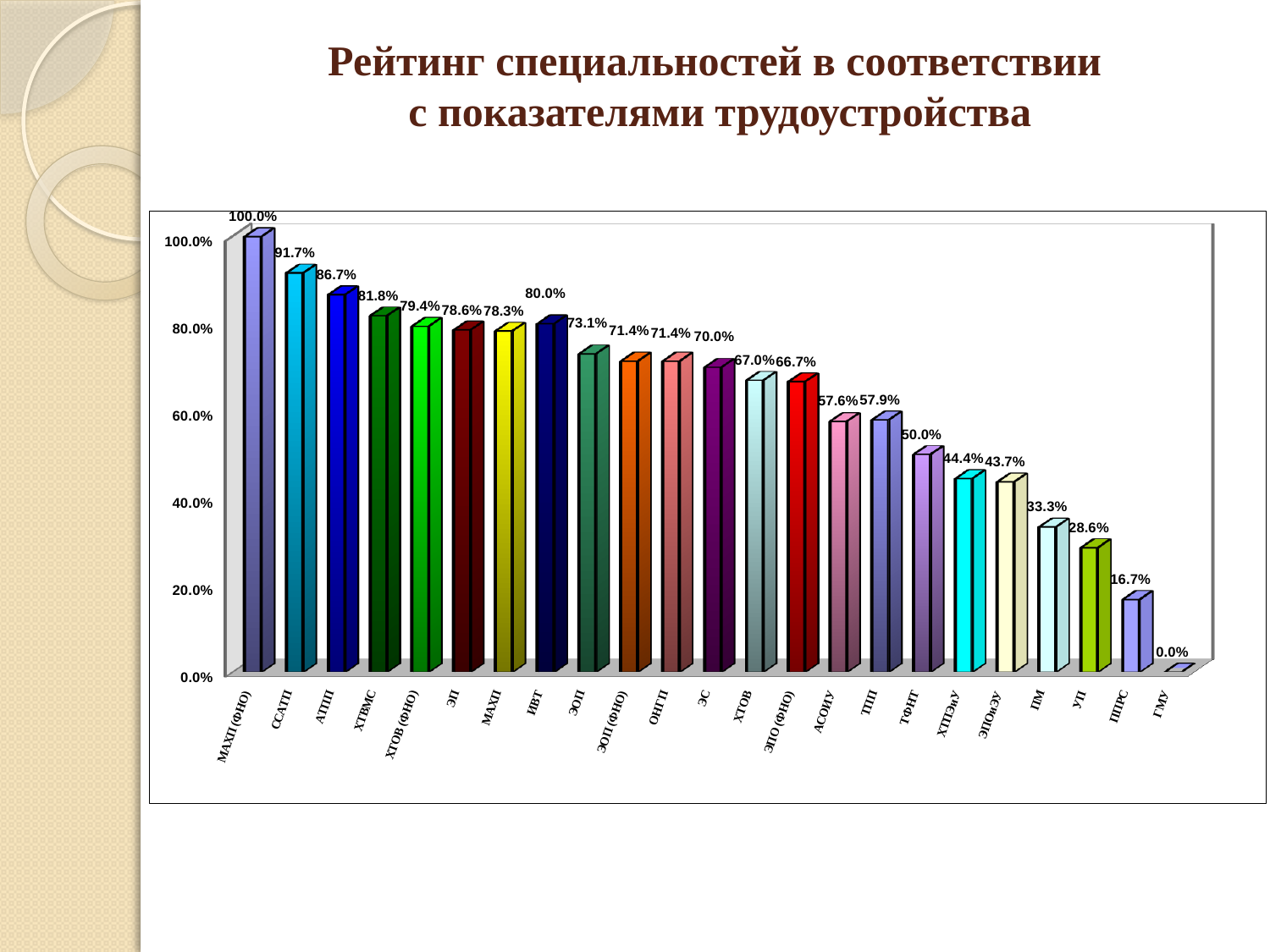
Which is larger, the value for ЭС or the value for ХТОВ? ЭС Is the value for ПМ greater or less than 40.0%? less What is the difference between the values for АТПП and ХТВМС? 4.9% Which category has the lowest value? ГМУ What is the value for ИВТ? 80.0% Which category has the highest value? МАХП (ФНО) What is the value for ТФНТ? 50.0% What is the title of the chart on the slide? Рейтинг специальностей в соответствии с показателями трудоустройства How many categories are shown on the chart? 23 What is the value for ППРС? 16.7% What kind of chart is shown on the slide? bar chart What is the value for ССАТП? 91.7%